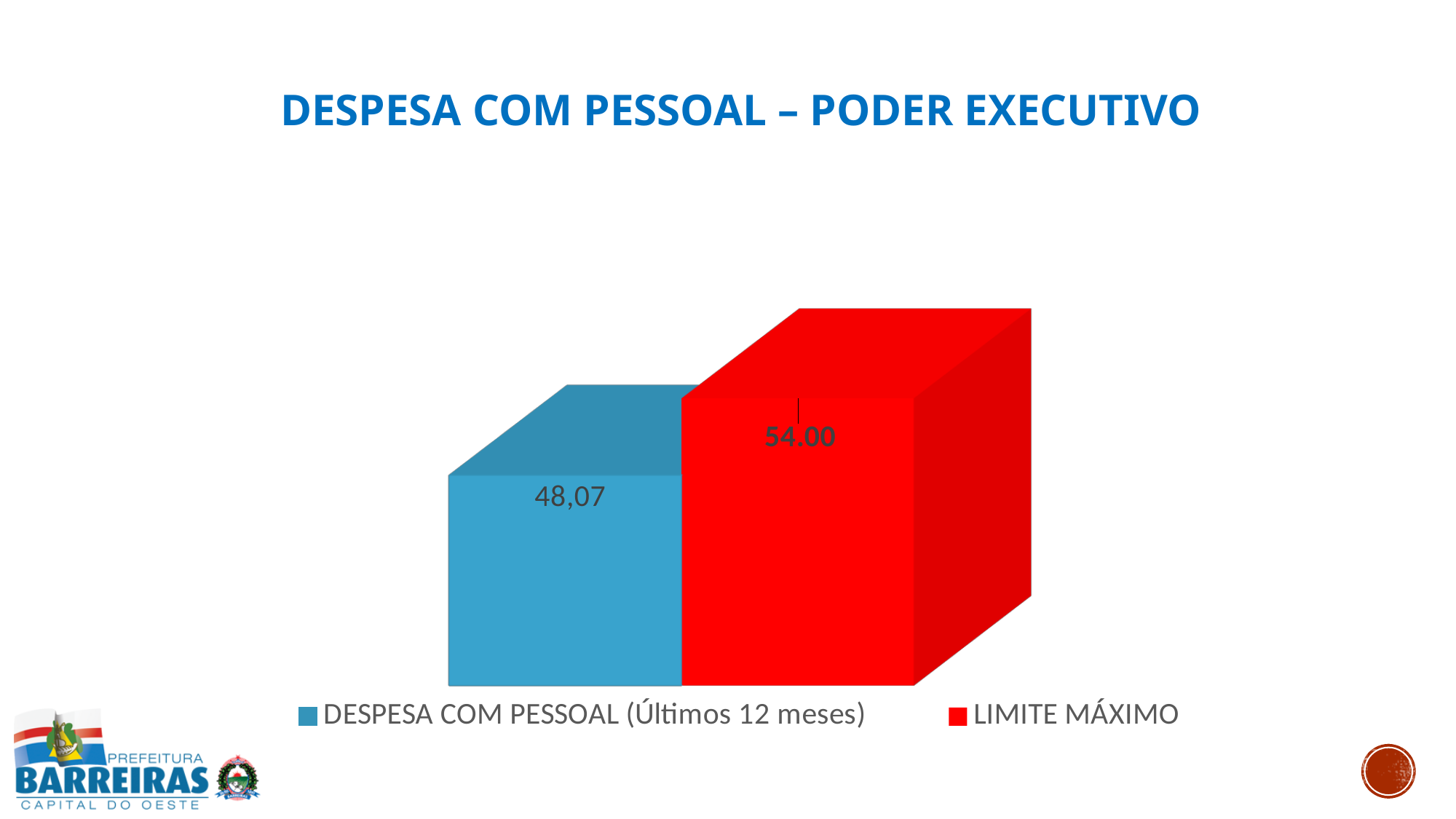
How many series does the legend list? 2 How many bars are plotted in the chart? 2 What is the value shown for LIMITE MÁXIMO? 54.00 What is the difference between the LIMITE MÁXIMO value and the DESPESA COM PESSOAL (Últimos 12 meses) value? 5.93 What is the title of the chart? DESPESA COM PESSOAL – PODER EXECUTIVO Which series has the lower value? DESPESA COM PESSOAL (Últimos 12 meses) What kind of chart is shown on the slide? bar chart What colour is the bar for LIMITE MÁXIMO? red What is the value shown for DESPESA COM PESSOAL (Últimos 12 meses)? 48,07 Which series has the higher value? LIMITE MÁXIMO Is the value for DESPESA COM PESSOAL (Últimos 12 meses) larger or smaller than the value for LIMITE MÁXIMO? smaller